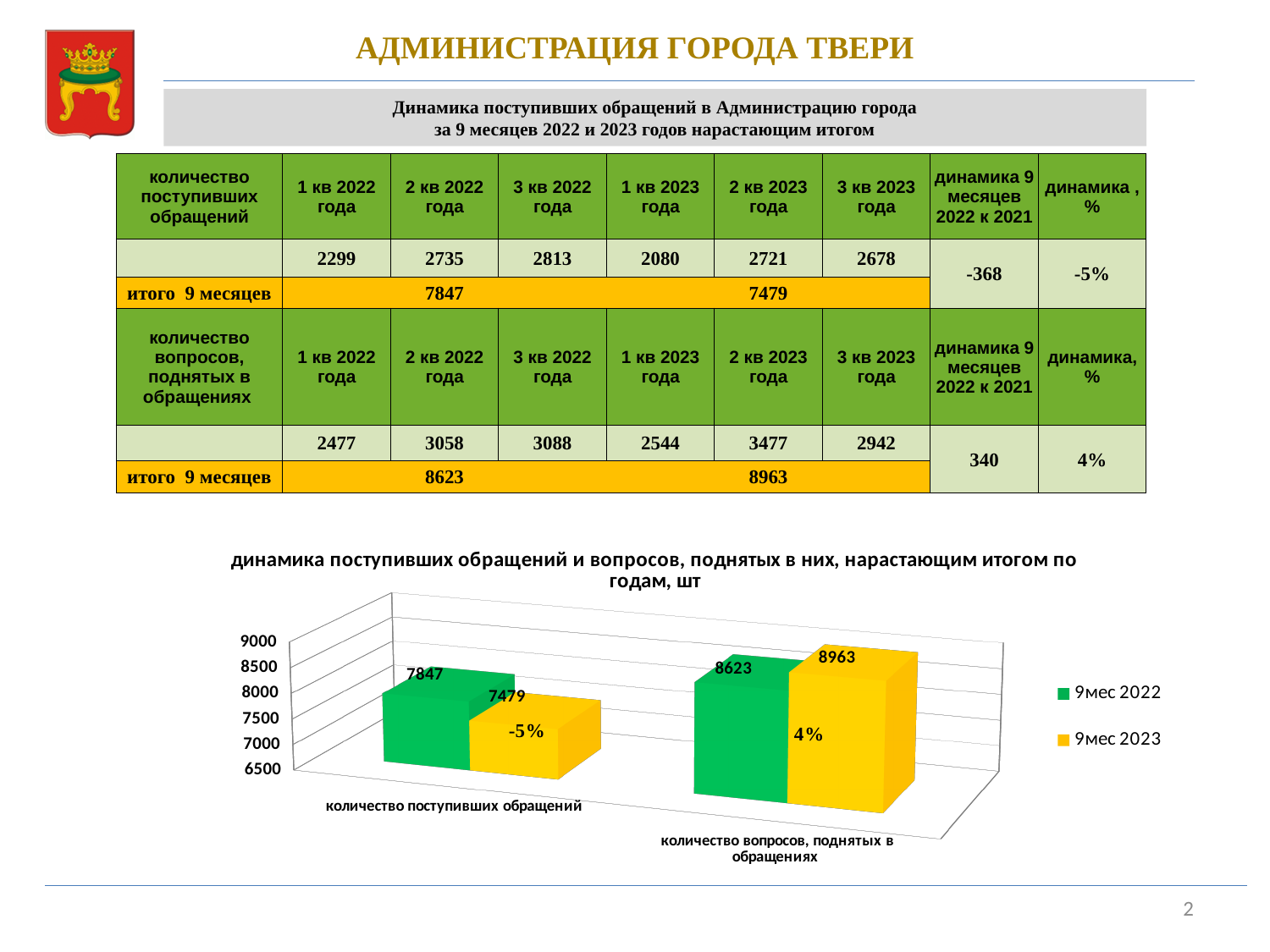
For "количество вопросов, поднятых в обращениях", which series is larger: "9мес 2022" or "9мес 2023"? 9мес 2023 What is the value for "9мес 2022" in the "количество вопросов, поднятых в обращениях" category? 8623 What is the difference between the "9мес 2023" and "9мес 2022" values for "количество вопросов, поднятых в обращениях"? 340 What kind of chart is shown on the slide? Bar chart Which bar has the highest value on the chart? 9мес 2023, количество вопросов, поднятых в обращениях Which bar has the lowest value on the chart? 9мес 2023, количество поступивших обращений What is the difference between the "9мес 2022" and "9мес 2023" values for "количество поступивших обращений"? 368 What is the value for "9мес 2023" in the "количество вопросов, поднятых в обращениях" category? 8963 What is the value for "9мес 2023" in the "количество поступивших обращений" category? 7479 What is the value for "9мес 2022" in the "количество поступивших обращений" category? 7847 How many series does the legend list? 2 How many categories are shown on the x axis of the chart? 2